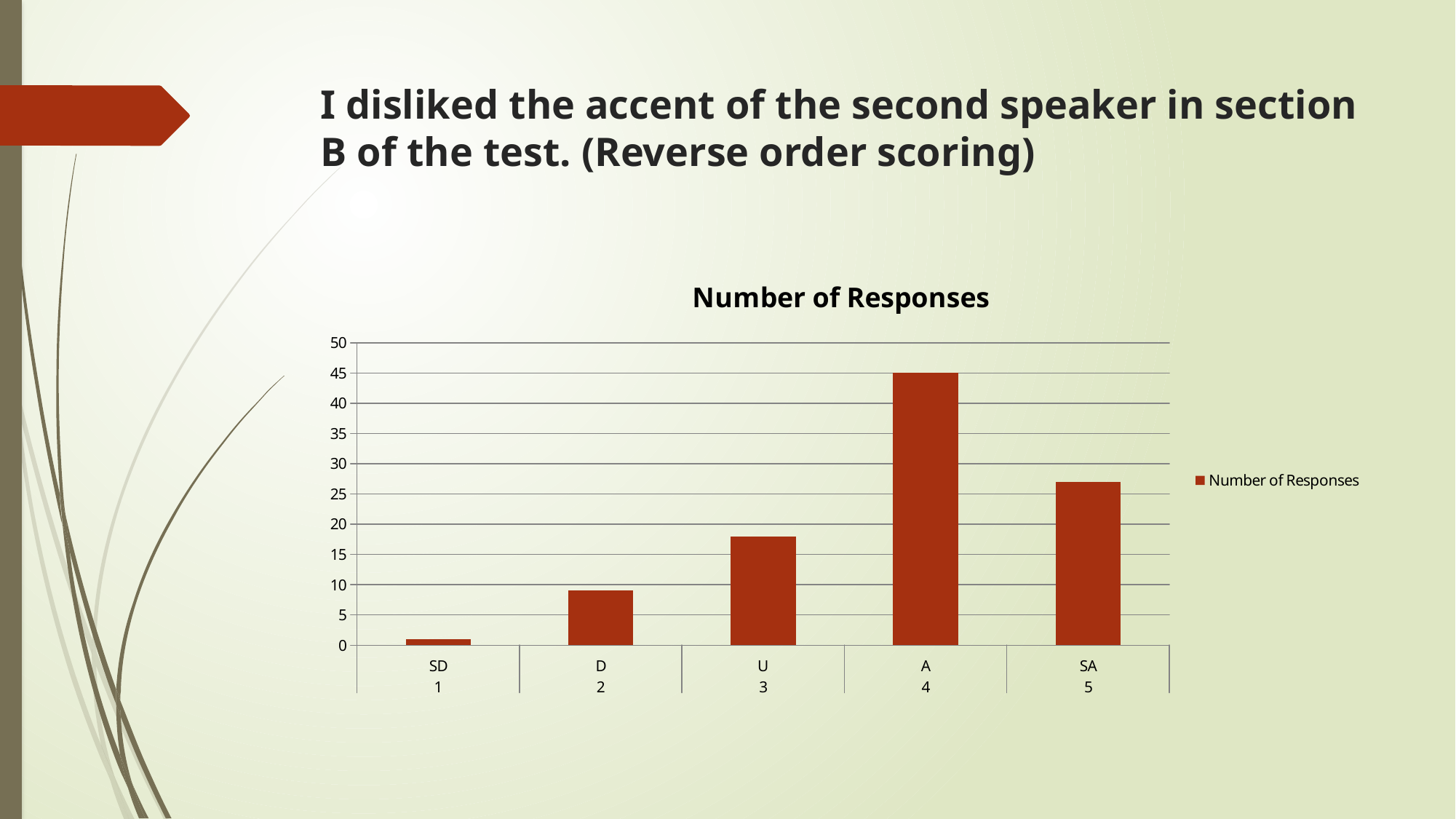
What is the legend entry shown on the chart? Number of Responses How many categories are shown on the x axis of the chart? 5 What is the number of responses for A (4)? 45 Which category has the lowest number of responses? SD (1) Which has more responses, U (3) or SA (5)? SA (5) Which category has the highest number of responses? A (4) Is the value for D (2) greater or less than 10? less What is the title of the chart? Number of Responses What kind of chart is shown on the slide? bar chart Is the value for U (3) greater or less than 15? greater Is the value for SA (5) greater or less than 25? greater How many series does the legend list? 1